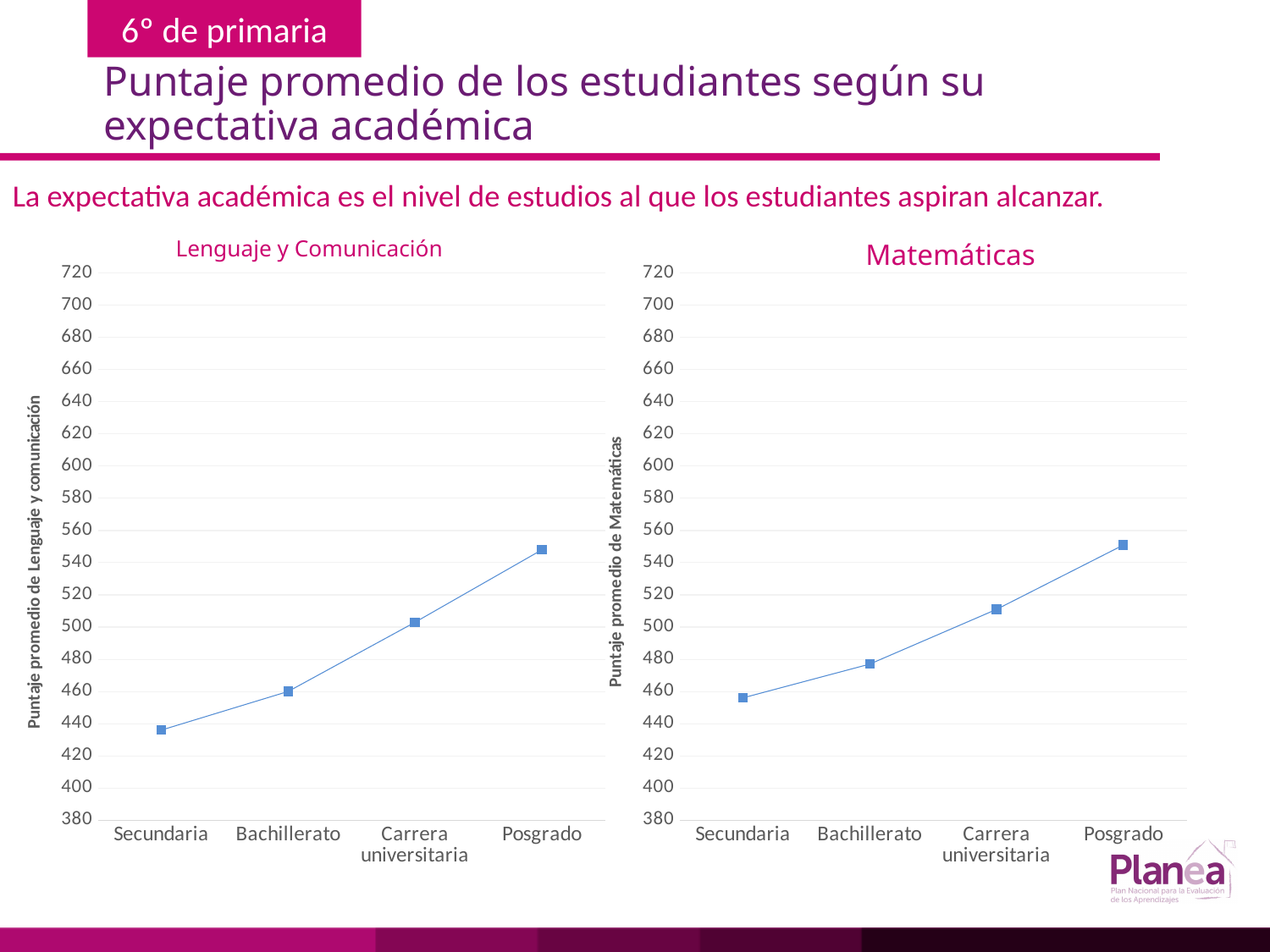
In the Matemáticas chart, is the value for Bachillerato greater or less than 500? less In the Matemáticas chart, which is larger, the value for Secundaria or the value for Carrera universitaria? Carrera universitaria In the Matemáticas chart, is the value for Carrera universitaria greater or less than 500? greater In the Lenguaje y Comunicación chart, is the value for Secundaria greater or less than 460? less In the Lenguaje y Comunicación chart, do the values rise or fall from Secundaria to Posgrado? rise What is the y-axis label of the chart on the left? Puntaje promedio de Lenguaje y comunicación In the Matemáticas chart, which category has the highest value? Posgrado How many categories are shown on the x axis of the Matemáticas chart? 4 In the Lenguaje y Comunicación chart, which category has the lowest value? Secundaria What kind of chart is the Lenguaje y Comunicación chart? line chart What is the title of the chart on the right? Matemáticas